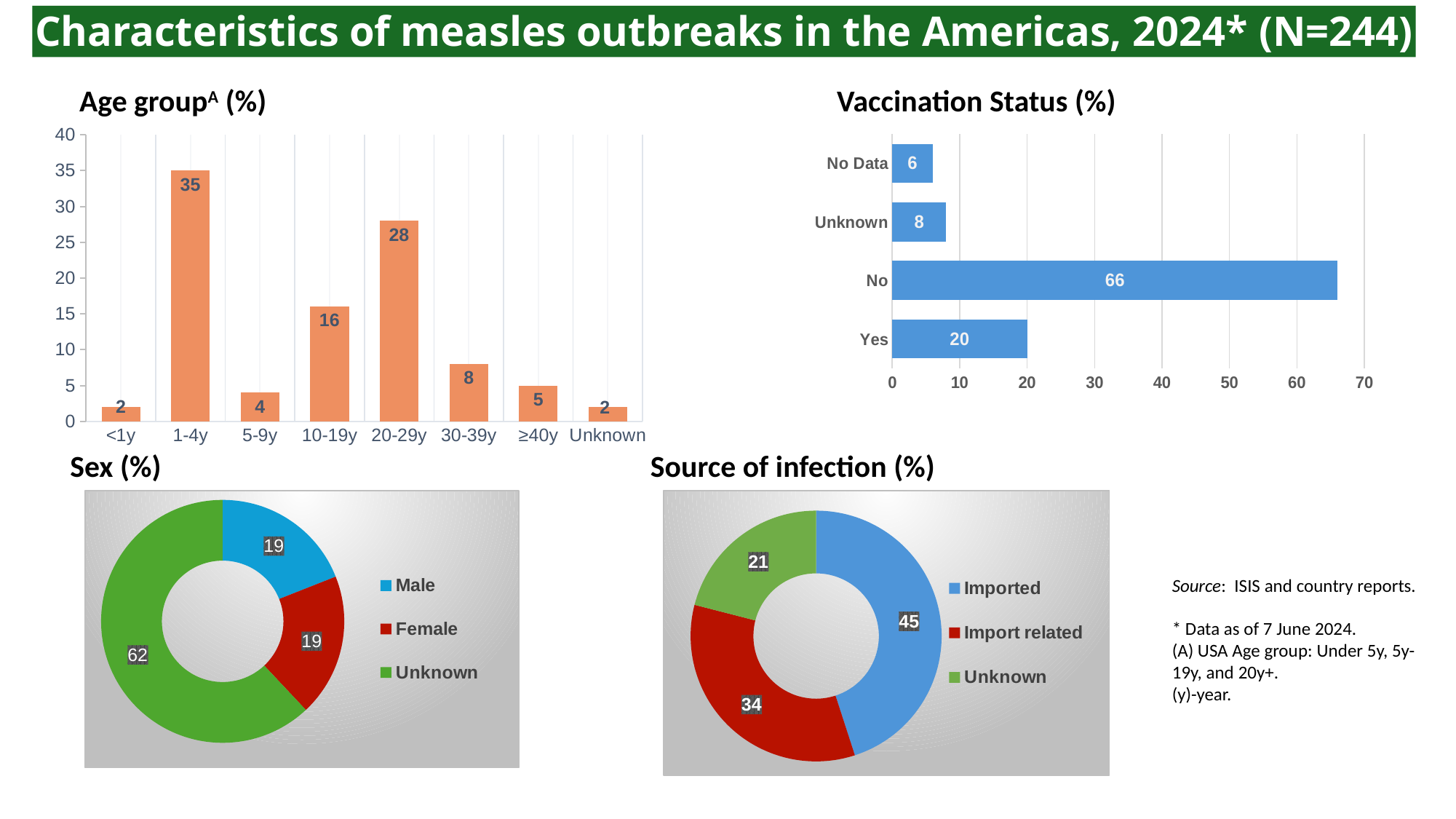
In the Age group (%) chart, what is the difference between the values for 20-29y and 10-19y? 12 What kind of chart is the Vaccination Status (%) chart? Bar chart In the Vaccination Status (%) chart, which category has the lowest value? No Data In the Age group (%) chart, what is the value for the 1-4y age group? 35 In the Age group (%) chart, which age group has the highest value? 1-4y In the Sex (%) chart, what is the value for Unknown? 62 In the Vaccination Status (%) chart, what is the value for No? 66 In the Age group (%) chart, how many age group categories are shown on the x axis? 8 In the Source of infection (%) chart, what is the value for Import related? 34 In the Source of infection (%) chart, which category has the largest share? Imported In the Vaccination Status (%) chart, which is larger, the value for Yes or the value for Unknown? Yes How many series does the legend of the Source of infection (%) chart list? 3